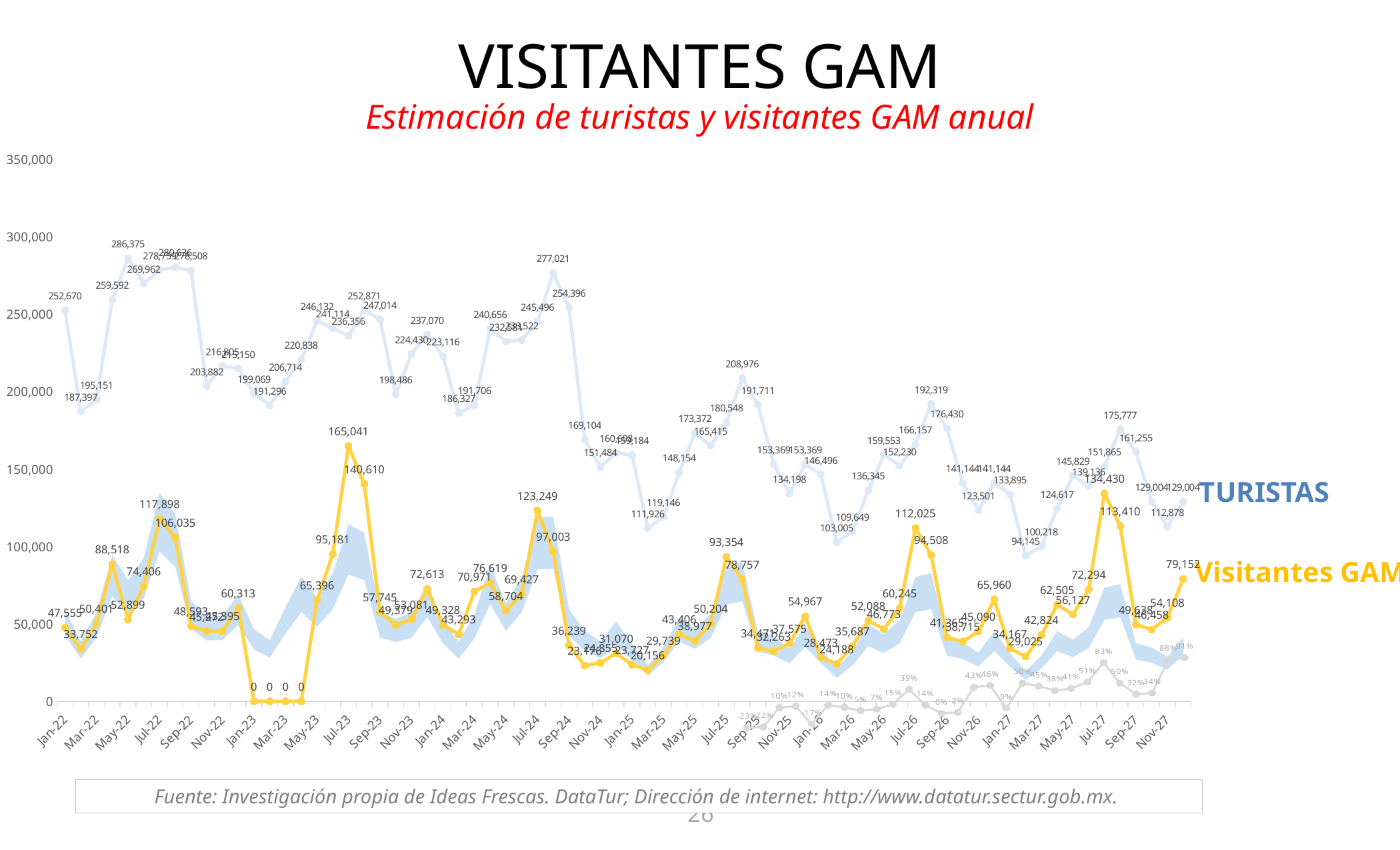
How many consecutive months show a value of 0 for Visitantes GAM in early 2023? 4 What is the difference between TURISTAS and Visitantes GAM in Jan-22? 205,115 Which series is drawn with the yellow line? Visitantes GAM What is the value of TURISTAS in Jan-22? 252,670 What is the highest value shown for the Visitantes GAM series? 165,041 What kind of chart is shown on the slide? line chart What is the value of TURISTAS in Jul-25? 180,548 Which series has the larger value in Jan-22, TURISTAS or Visitantes GAM? TURISTAS Is the value of Visitantes GAM in Jul-23 greater or less than 150,000? greater What is the value of Visitantes GAM in Jan-22? 47,555 What is the highest value shown for the TURISTAS series? 286,375 What is the value of Visitantes GAM in Jul-24? 123,249